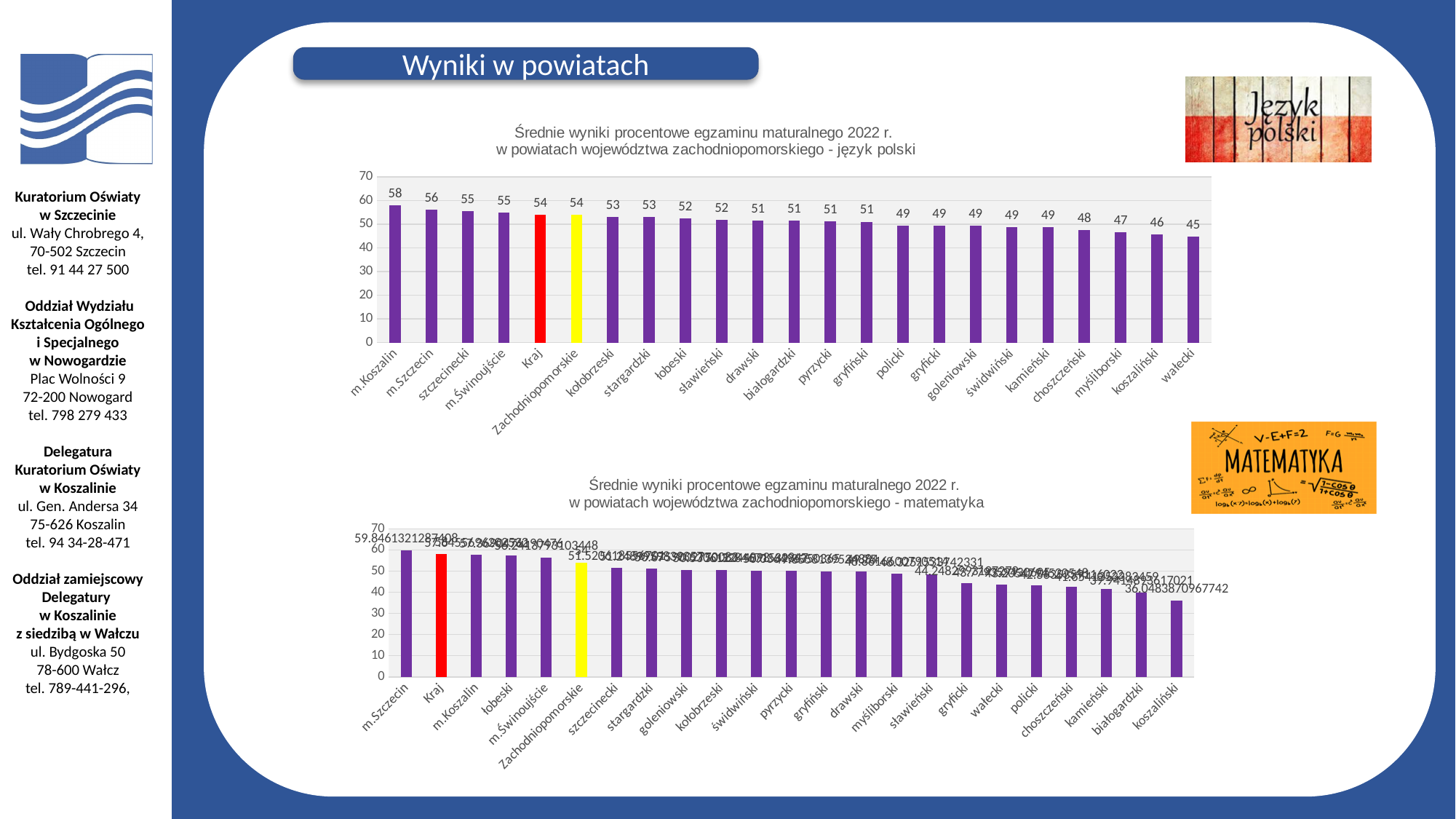
In the top chart (język polski), what is the difference between the values for m.Koszalin and wałecki? 13 How many categories are shown in the top chart (język polski)? 23 What kind of chart is the bottom chart (matematyka)? bar chart In the top chart (język polski), what is the value for Kraj? 54 In the top chart (język polski), which category has the lowest value? wałecki In the bottom chart (matematyka), which category has the lowest value? koszaliński In the bottom chart (matematyka), is the value for wałecki greater or less than 50? less In the top chart (język polski), which category has the highest value? m.Koszalin In the bottom chart (matematyka), is the value for m.Koszalin greater or less than 50? greater In the top chart (język polski), which is larger, the value for kołobrzeski or the value for choszczeński? kołobrzeski In the top chart (język polski), what is the value for m.Koszalin? 58 In the top chart (język polski), what is the value for wałecki? 45